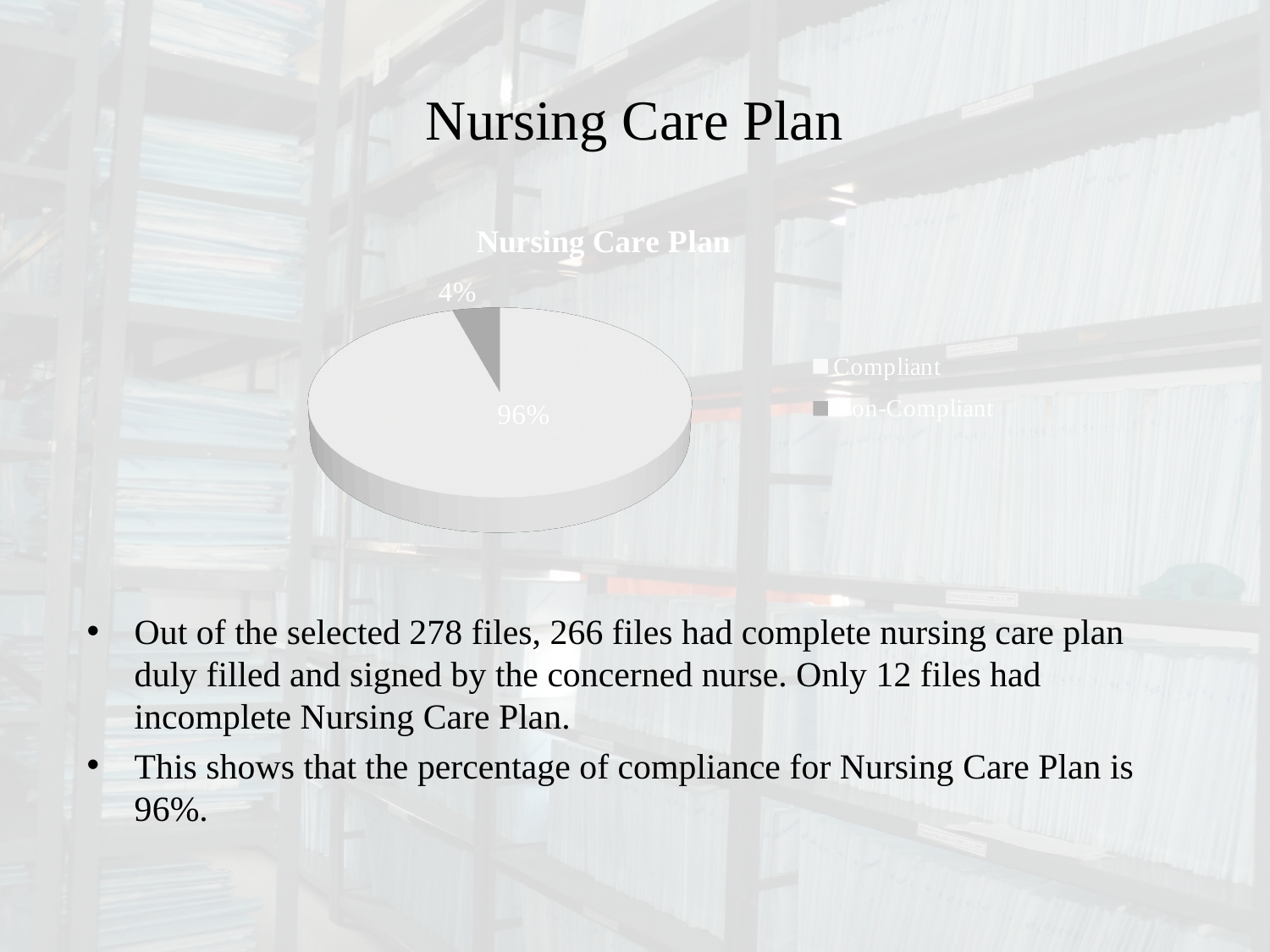
What is the title of the chart? Nursing Care Plan What is the difference in percentage points between the Compliant and Non-Compliant slices? 92 Which is larger, the Compliant slice or the Non-Compliant slice? Compliant What share of the pie does the Compliant slice take? 96% What percentage of the pie is labelled for the Compliant slice? 96% What kind of chart is shown on the slide? Pie chart What percentage of the pie is labelled for the Non-Compliant slice? 4% Which slice of the pie is the largest? Compliant Which slice of the pie is the smallest? Non-Compliant How many entries does the legend list? 2 What are the two legend entries of the chart? Compliant and Non-Compliant How many slices does the pie chart have? 2